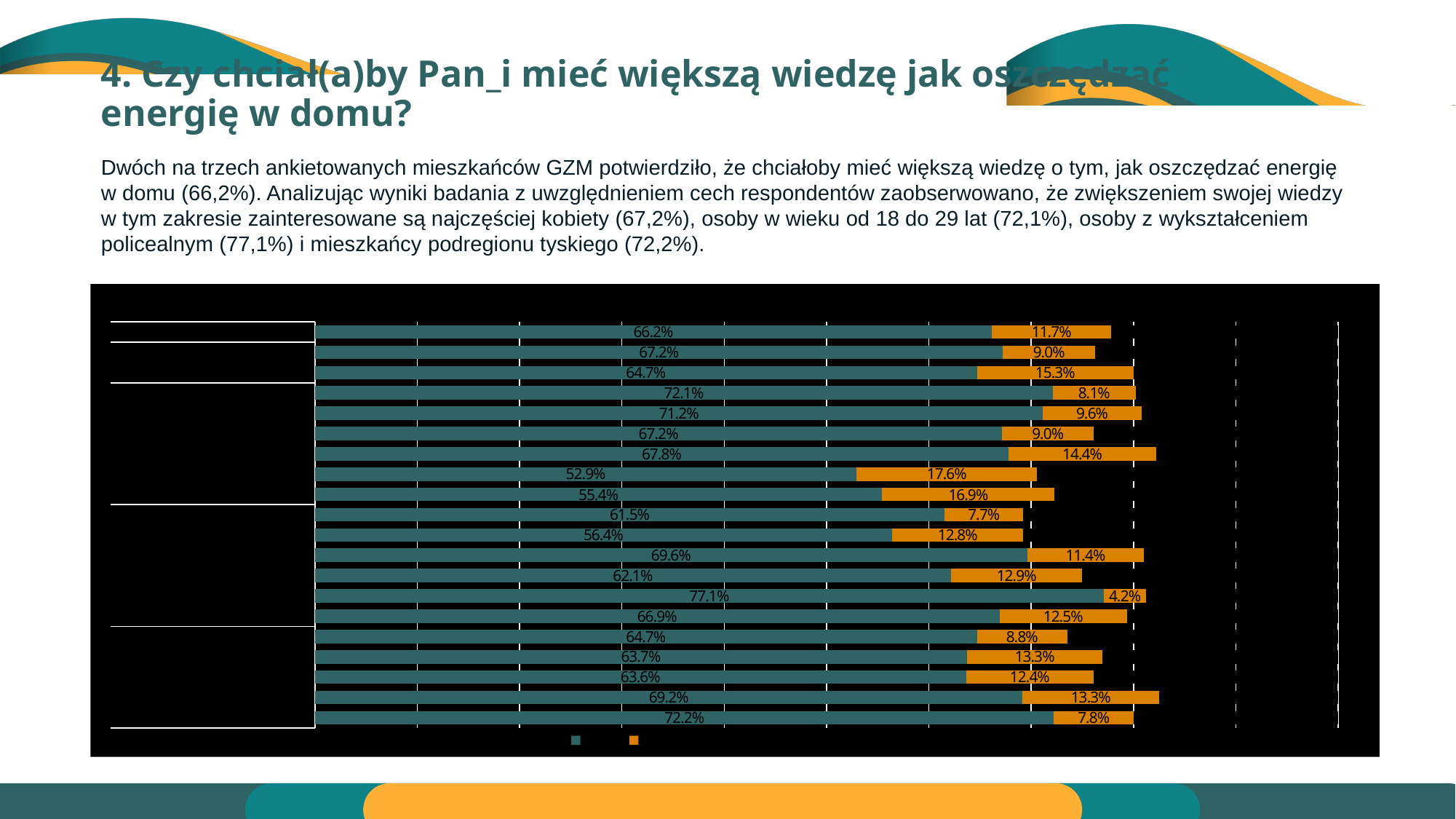
What is the lowest value labelled on the orange segments of the chart? 4.2% What kind of chart is shown on the slide? bar chart What is the teal value labelled on the topmost bar of the chart? 66.2% What is the lowest value labelled on the teal segments of the chart? 52.9% How many bars are plotted in the chart? 20 What is the highest value labelled on the teal segments of the chart? 77.1% What is the total of the teal and orange segments of the topmost bar (66.2% and 11.7%)? 77.9% What is the highest value labelled on the orange segments of the chart? 17.6% What is the orange value labelled on the bottommost bar of the chart? 7.8% What is the difference between the highest teal value (77.1%) and the lowest teal value (52.9%)? 24.2 percentage points Which two colours are used for the bar segments in the chart? teal and orange